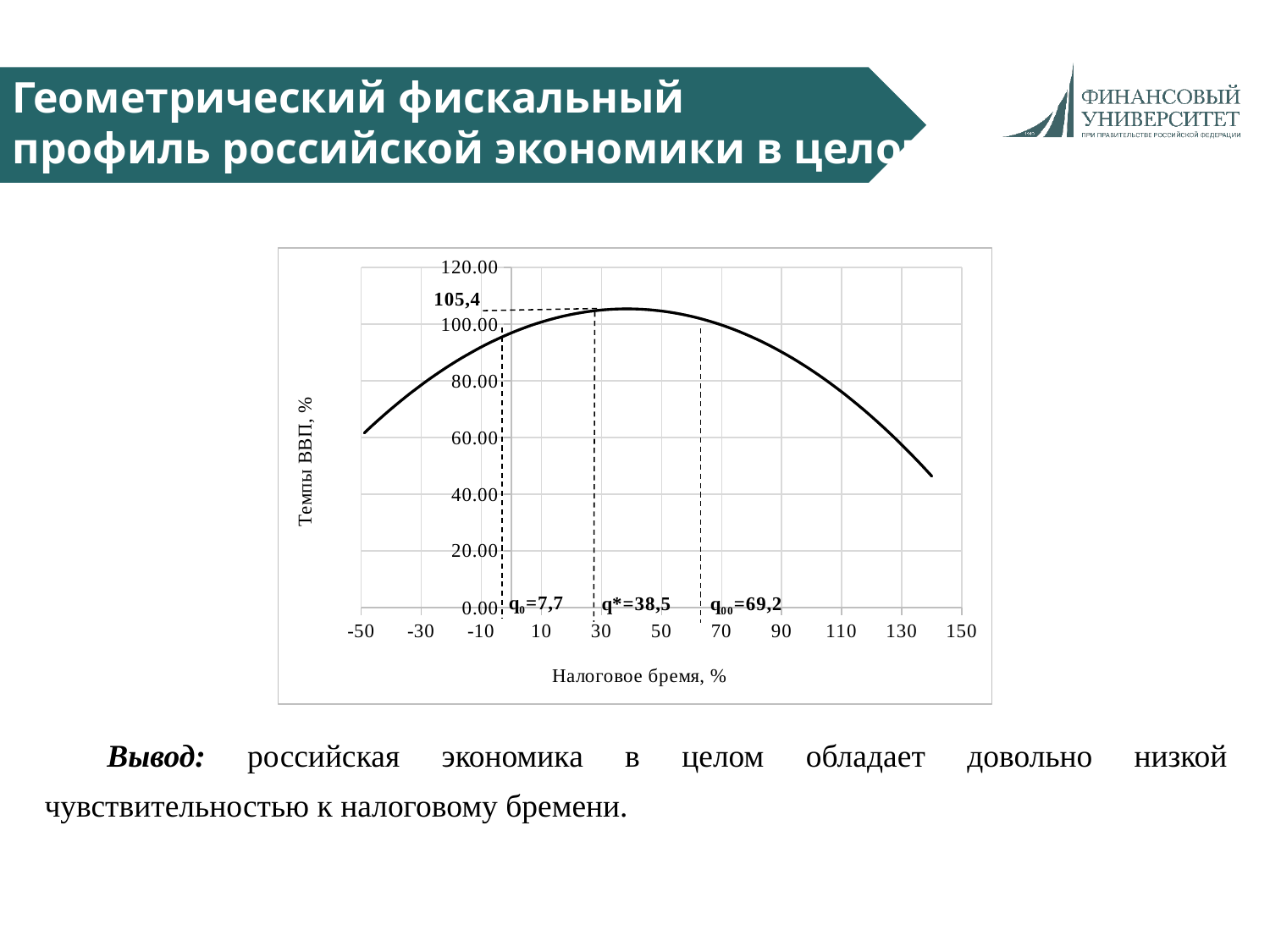
What is the value of q0 marked on the chart? 7,7 What is the value of q* marked on the chart? 38,5 Does the curve rise or fall as the tax burden increases from -50 to 10? rise Is the value of the curve at a tax burden of 90 greater or less than 80? greater Is the value of the curve at a tax burden of -50 greater or less than 80? less What is the value of q00 marked on the chart? 69,2 What is the maximum value of the GDP growth rate marked on the chart? 105,4 At which tax burden value does the curve reach its peak, according to the label on the chart? q*=38,5 What is the title of the vertical axis of the chart? Темпы ВВП, % Does the curve rise or fall as the tax burden increases from 70 to 150? fall What is the title of the horizontal axis of the chart? Налоговое бремя, % What kind of chart is shown on the slide? line chart